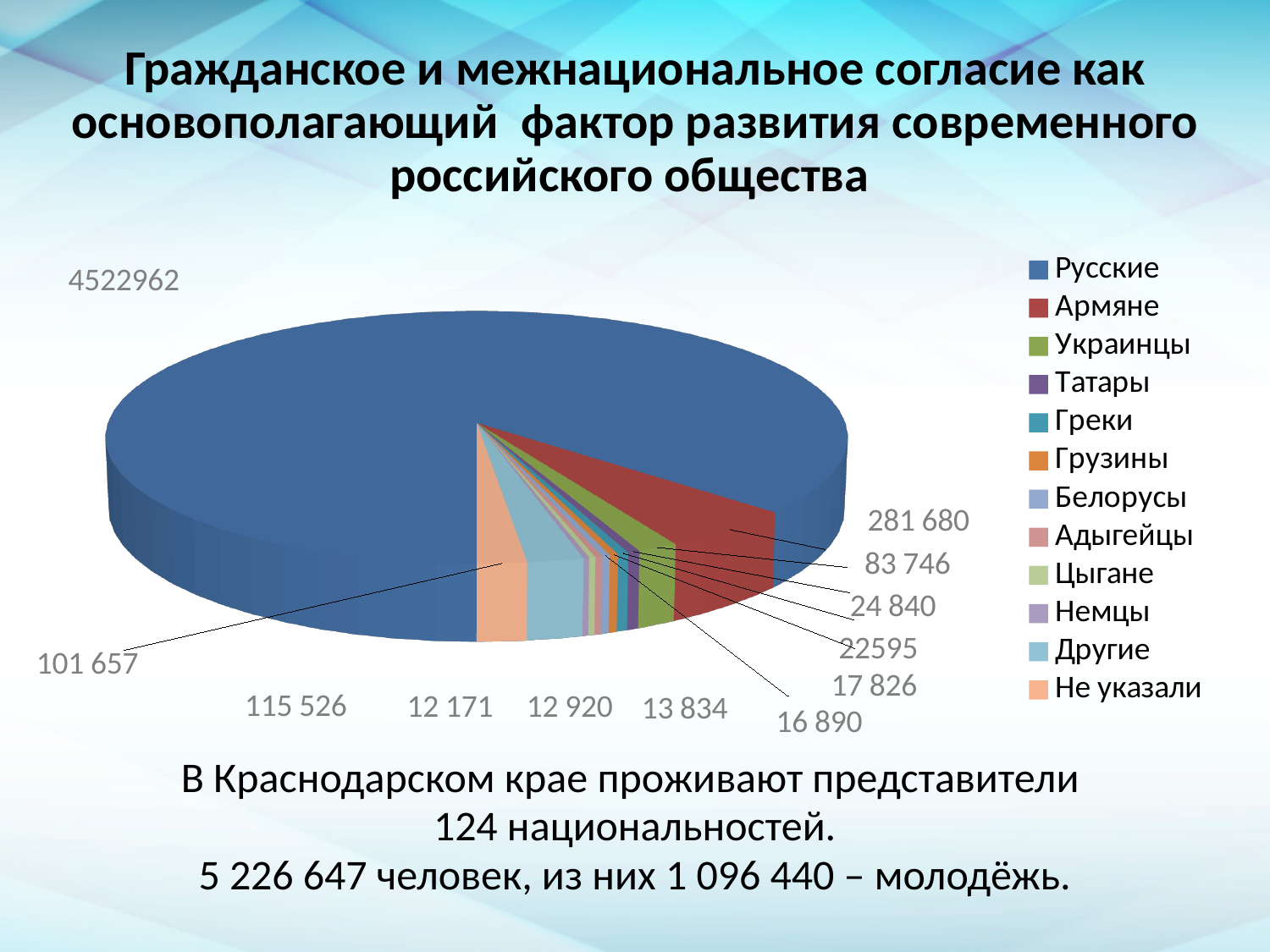
Which is larger on the pie chart, the value for Армяне or the value for Украинцы? Армяне What value is shown for Русские on the pie chart? 4522962 What value is shown for Украинцы on the pie chart? 83 746 What value is shown for Другие on the pie chart? 115 526 What is the difference between the values for Армяне and Украинцы on the pie chart? 197 934 What is the difference between the values for Другие and Не указали on the pie chart? 13 869 What value is shown for Не указали on the pie chart? 101 657 What kind of chart is shown on the slide? pie chart What colour is the slice for Русские on the pie chart? blue What value is shown for Армяне on the pie chart? 281 680 How many categories does the legend of the pie chart list? 12 Which category has the largest slice of the pie chart? Русские